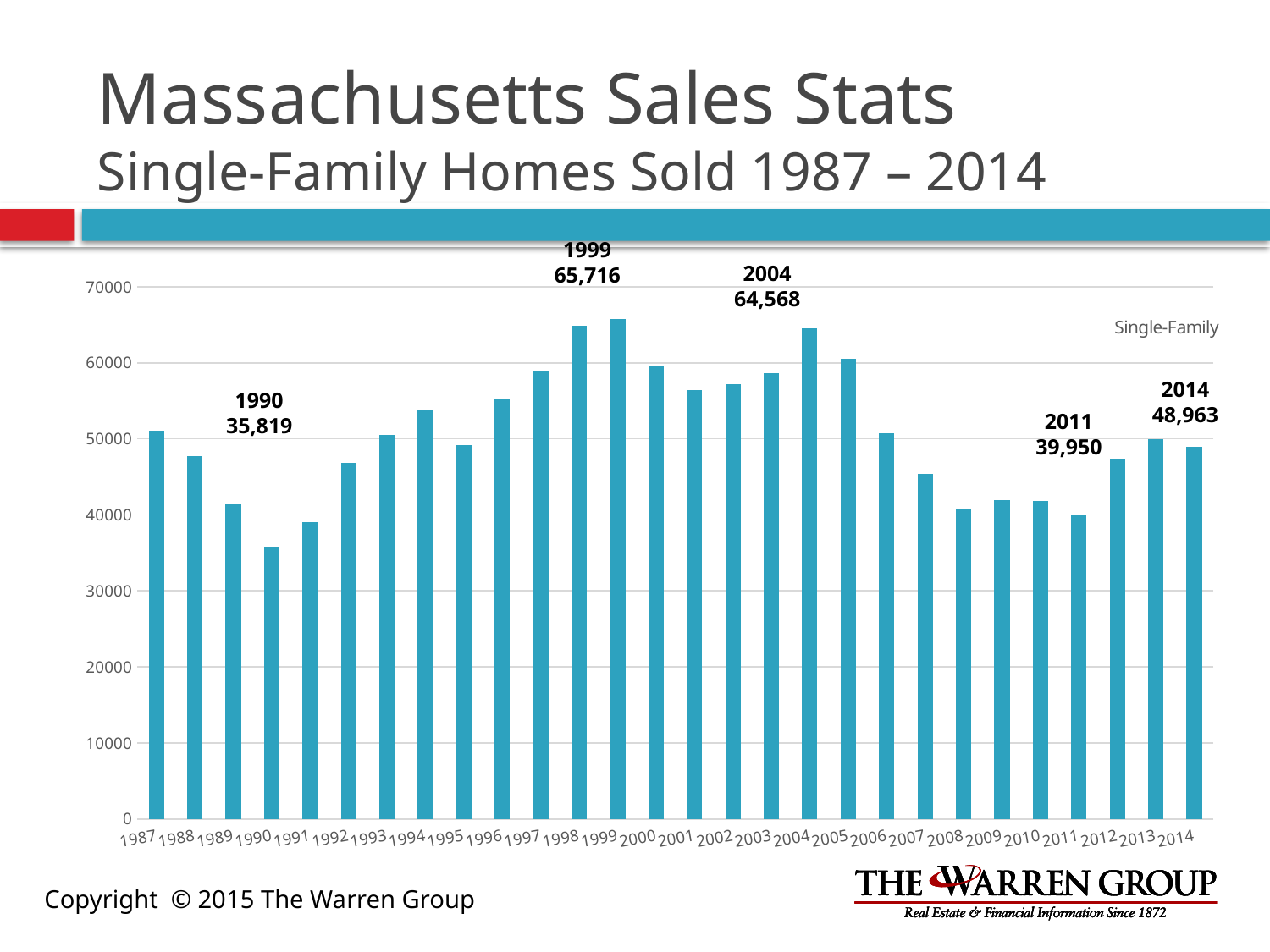
Which year has the lowest number of single-family homes sold? 1990 What is the value shown for 2014? 48,963 Which year had more homes sold, 1990 or 2011? 2011 What is the difference between the 1999 value and the 2004 value? 1,148 How many years are plotted on the chart? 28 Do the values rise or fall from 1987 to 1990? fall Is the value for 2008 greater or less than 50000? less What is the value shown for 2011? 39,950 Which year has the highest number of single-family homes sold? 1999 How many single-family homes were sold in Massachusetts in 1999? 65,716 What kind of chart is shown on the slide? bar chart How much higher is the 2014 value than the 2011 value? 9,013